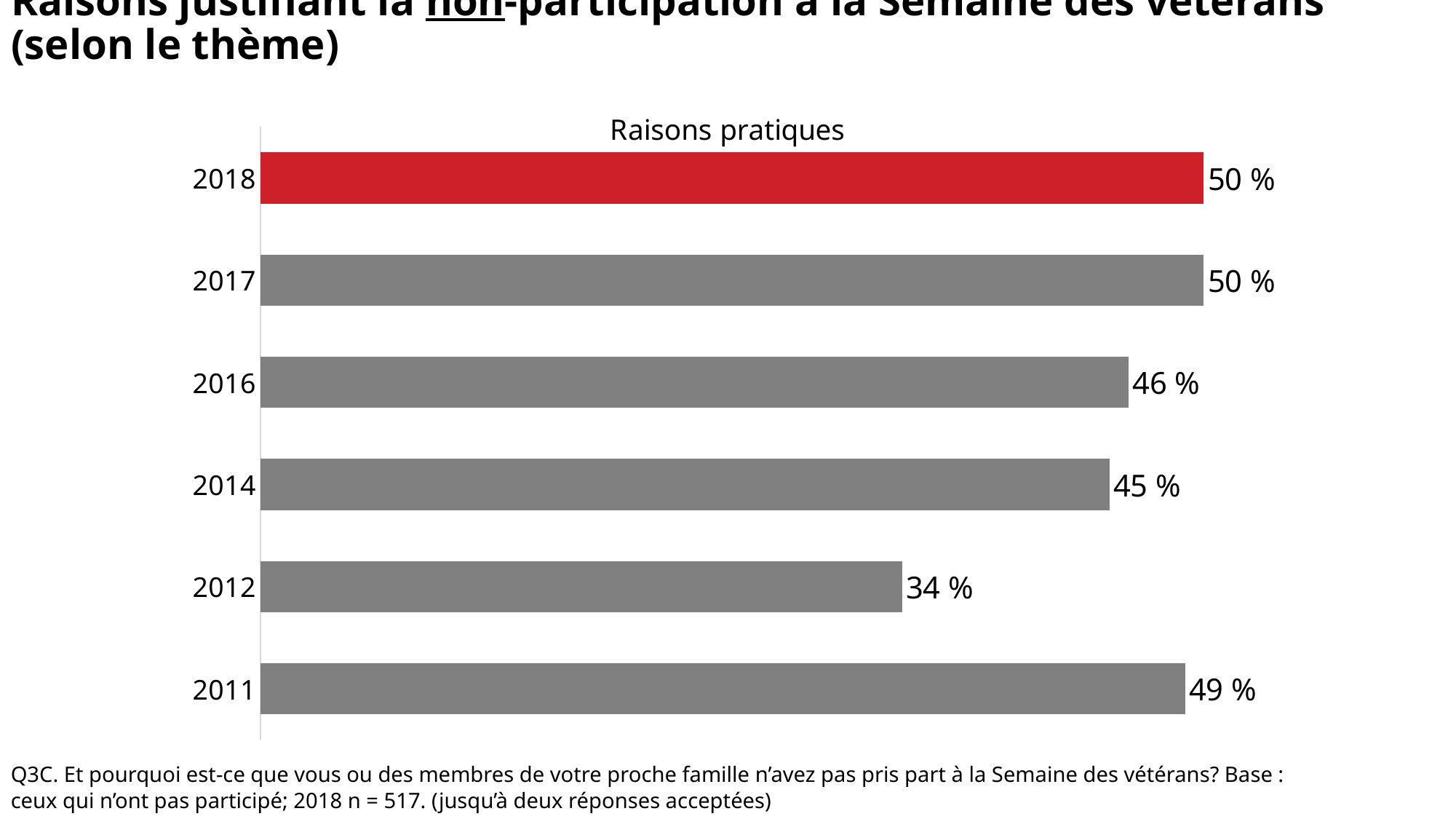
What is the value for 2011 in the Raisons pratiques chart? 49 % What is the title of the chart on the slide? Raisons pratiques Which year's bar is coloured red in the Raisons pratiques chart? 2018 What is the difference between the values for 2011 and 2012 in the Raisons pratiques chart? 15 % What is the value for 2018 in the Raisons pratiques chart? 50 % Which is larger in the Raisons pratiques chart, the value for 2016 or the value for 2012? 2016 How many years are shown in the Raisons pratiques chart? 6 What is the value for 2012 in the Raisons pratiques chart? 34 % What is the value for 2016 in the Raisons pratiques chart? 46 % What is the difference between the values for 2018 and 2014 in the Raisons pratiques chart? 5 % What kind of chart is shown on the slide? Bar chart Which year has the lowest value in the Raisons pratiques chart? 2012